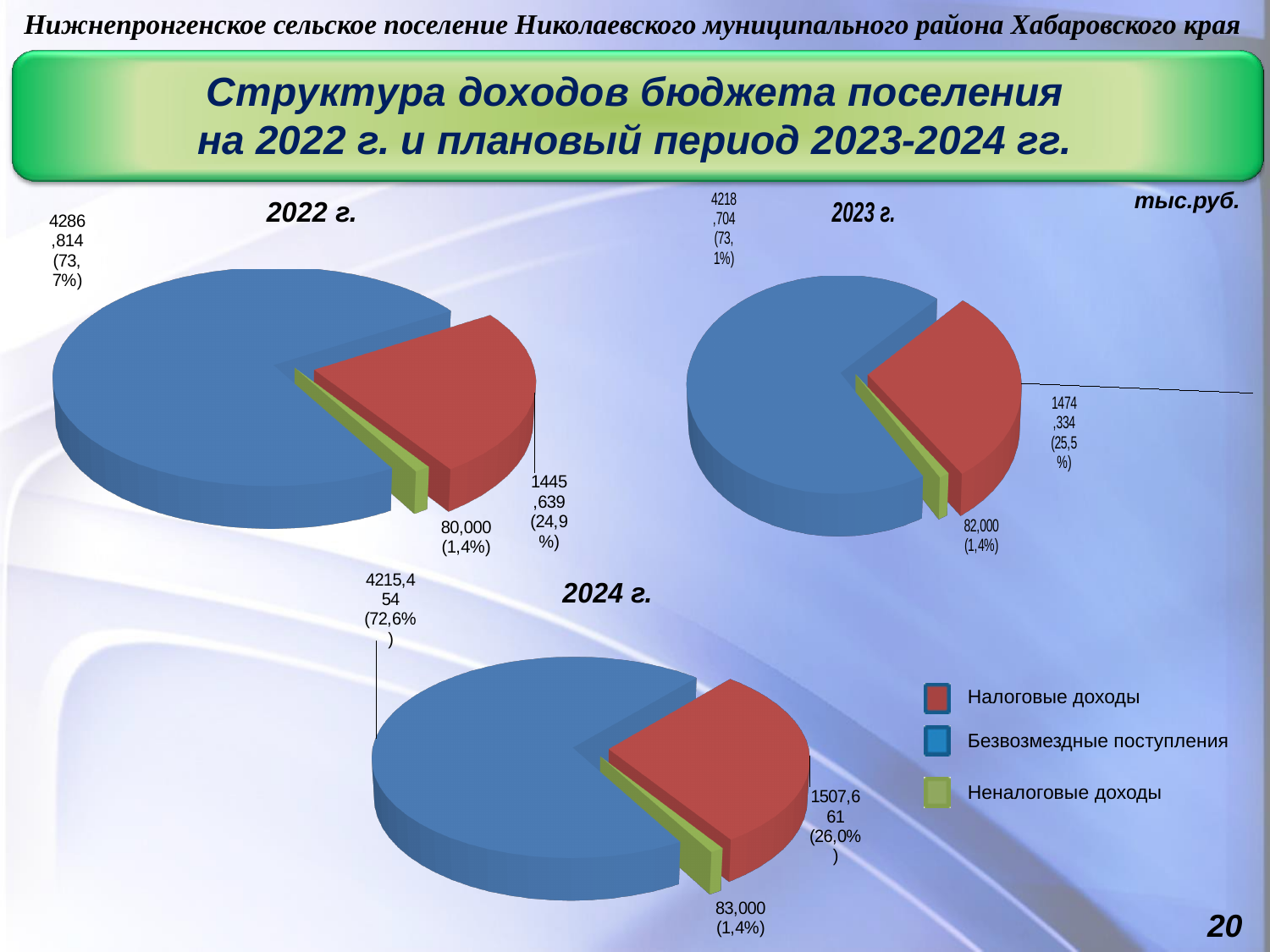
Which legend entry is shown in red? Налоговые доходы In the 2022 г. chart, what is the value for Безвозмездные поступления? 4286,814 What is the difference between Неналоговые доходы in the 2024 г. chart and in the 2022 г. chart? 3,000 In the 2024 г. chart, what is the value for Неналоговые доходы? 83,000 In the 2022 г. chart, what share of the pie is Налоговые доходы? 24,9% In the 2023 г. chart, what is the value for Налоговые доходы? 1474,334 In the 2024 г. chart, which category has the largest slice? Безвозмездные поступления Which is larger: Налоговые доходы in the 2024 г. chart or Налоговые доходы in the 2022 г. chart? 2024 г. How many series does the legend list? 3 In the 2023 г. chart, what share of the pie is Безвозмездные поступления? 73,1% What type of charts are shown on the slide? pie charts In the 2022 г. chart, which category has the smallest slice? Неналоговые доходы